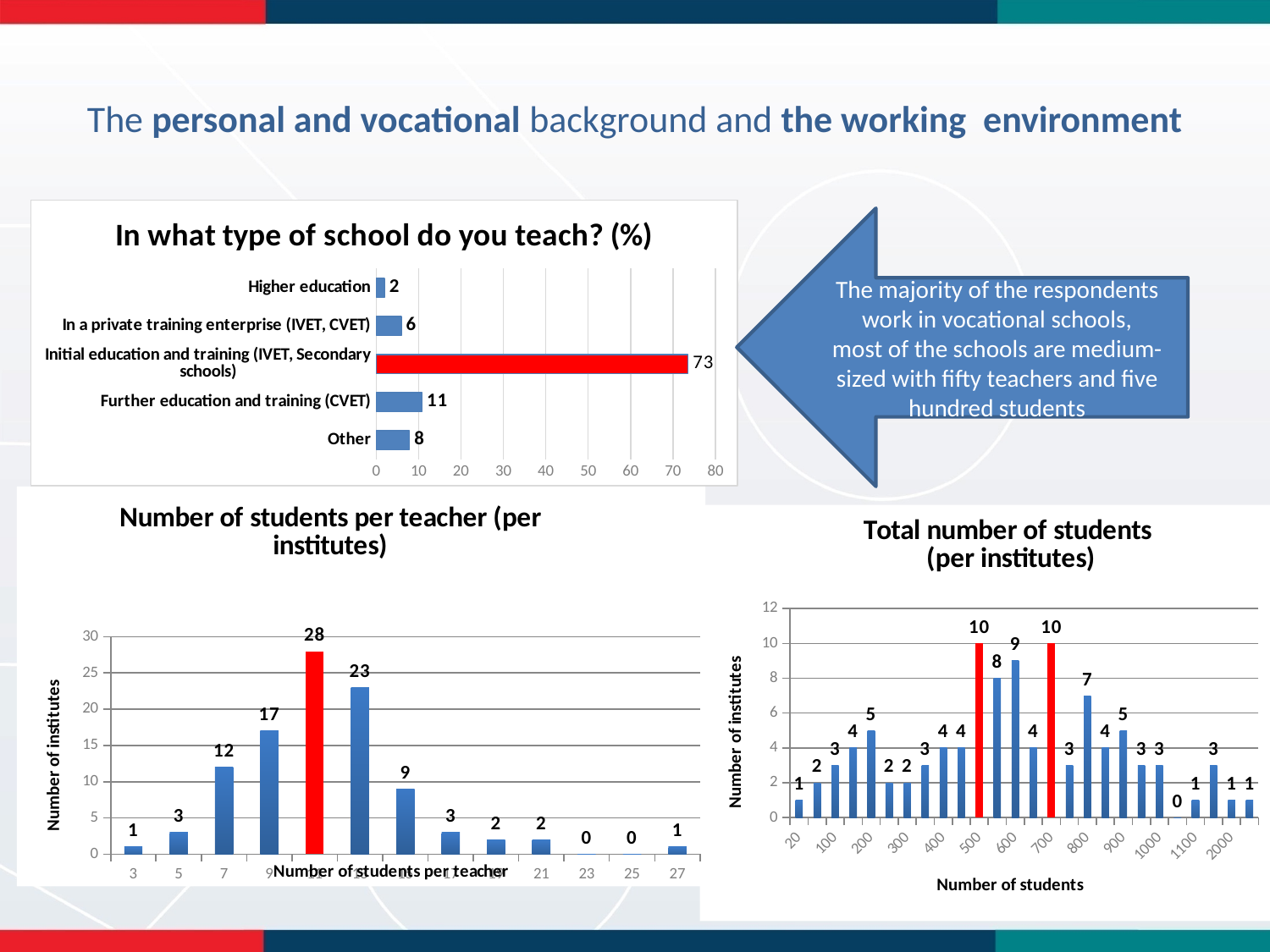
How many bars are shown in the chart 'Number of students per teacher (per institutes)'? 13 How many categories are shown in the chart 'In what type of school do you teach? (%)'? 5 In the chart 'Number of students per teacher (per institutes)', what is the value of the red bar? 28 In the chart 'In what type of school do you teach? (%)', what is the value for Higher education? 2 In the chart 'In what type of school do you teach? (%)', what is the difference between Further education and training (CVET) and Other? 3 In the chart 'In what type of school do you teach? (%)', which category has the lowest value? Higher education In the chart 'Number of students per teacher (per institutes)', what is the value for 7 students per teacher? 12 In the chart 'In what type of school do you teach? (%)', which category has the highest value? Initial education and training (IVET, Secondary schools) In the chart 'Total number of students (per institutes)', what is the highest value shown? 10 What kind of chart is 'Total number of students (per institutes)'? bar chart In the chart 'In what type of school do you teach? (%)', what is the value for Further education and training (CVET)? 11 In the chart 'In what type of school do you teach? (%)', which is larger: In a private training enterprise (IVET, CVET) or Other? Other